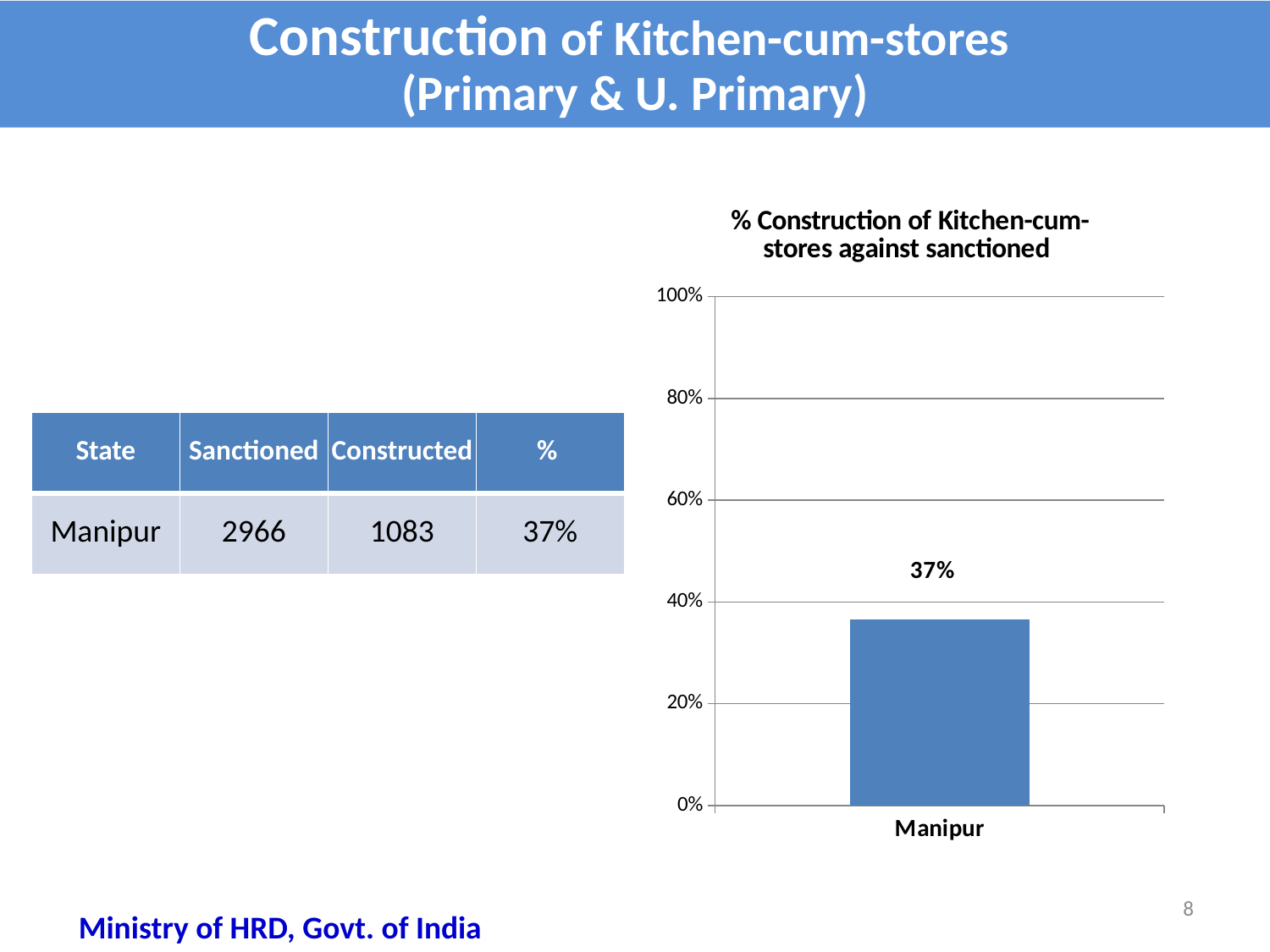
Is the value for Manipur greater or less than 40%? less What type of chart is shown on the slide? bar chart What is the value for Manipur in the chart? 37% What is the title of the chart? % Construction of Kitchen-cum-stores against sanctioned Is the value for Manipur greater or less than 20%? greater Which category is shown on the x axis of the chart? Manipur What is the maximum value shown on the chart's vertical axis? 100% How many categories are plotted in the chart? 1